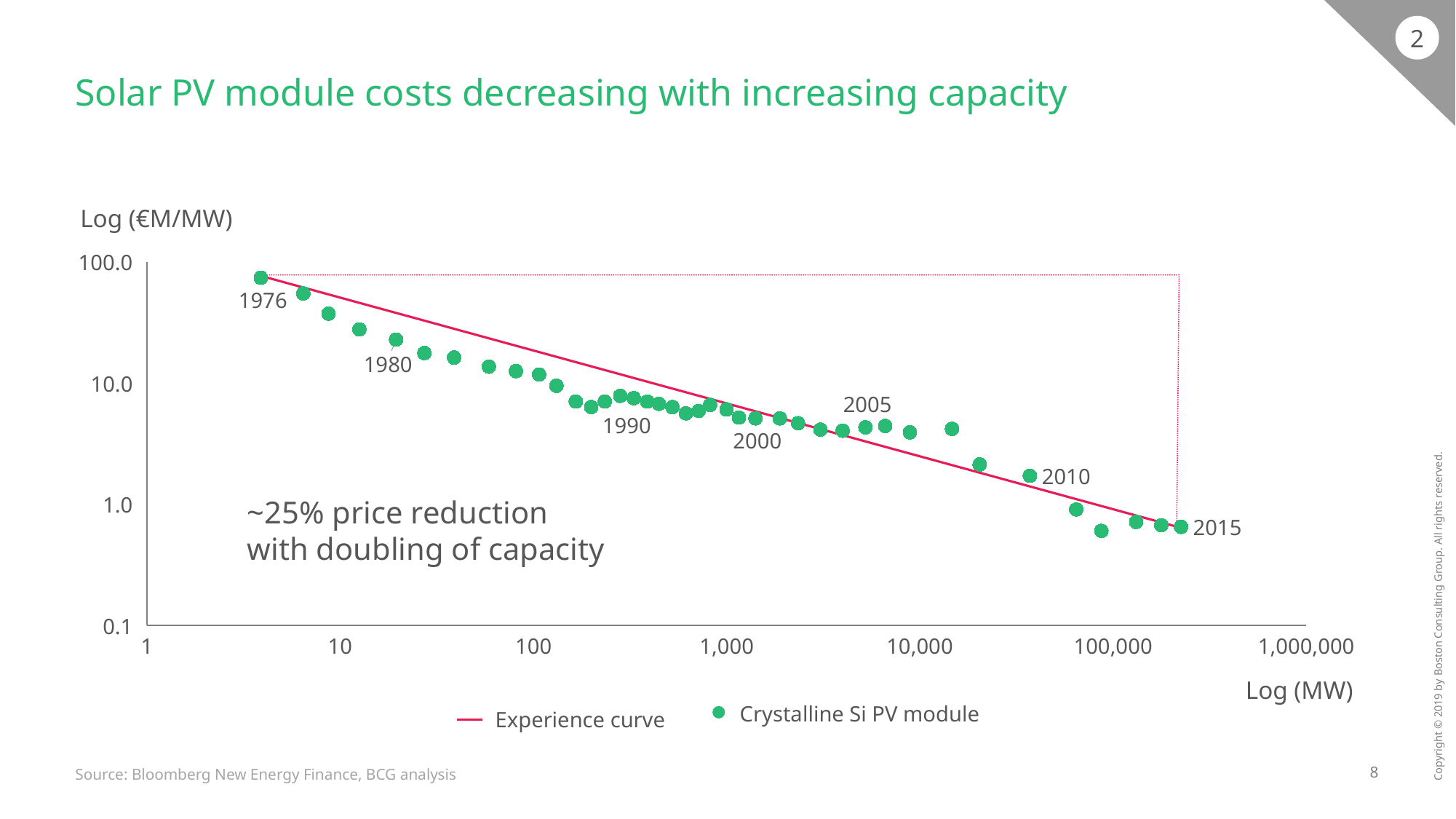
Is the module cost for 2000 greater or less than 10.0 €M/MW? less Which labelled year has the highest module cost? 1976 Which has the lower module cost, 1990 or 2010? 2010 How many series does the legend list? 2 Is the module cost for 2015 greater or less than 1.0 €M/MW? less What is the label of the vertical axis? Log (€M/MW) What are the two entries in the chart legend? Experience curve; Crystalline Si PV module Do the Crystalline Si PV module values rise or fall as capacity increases along the x axis? Fall Is the module cost for 1976 greater or less than 10.0 €M/MW? greater What kind of chart is shown on the slide? Scatter chart Which has the higher module cost, 1980 or 2005? 1980